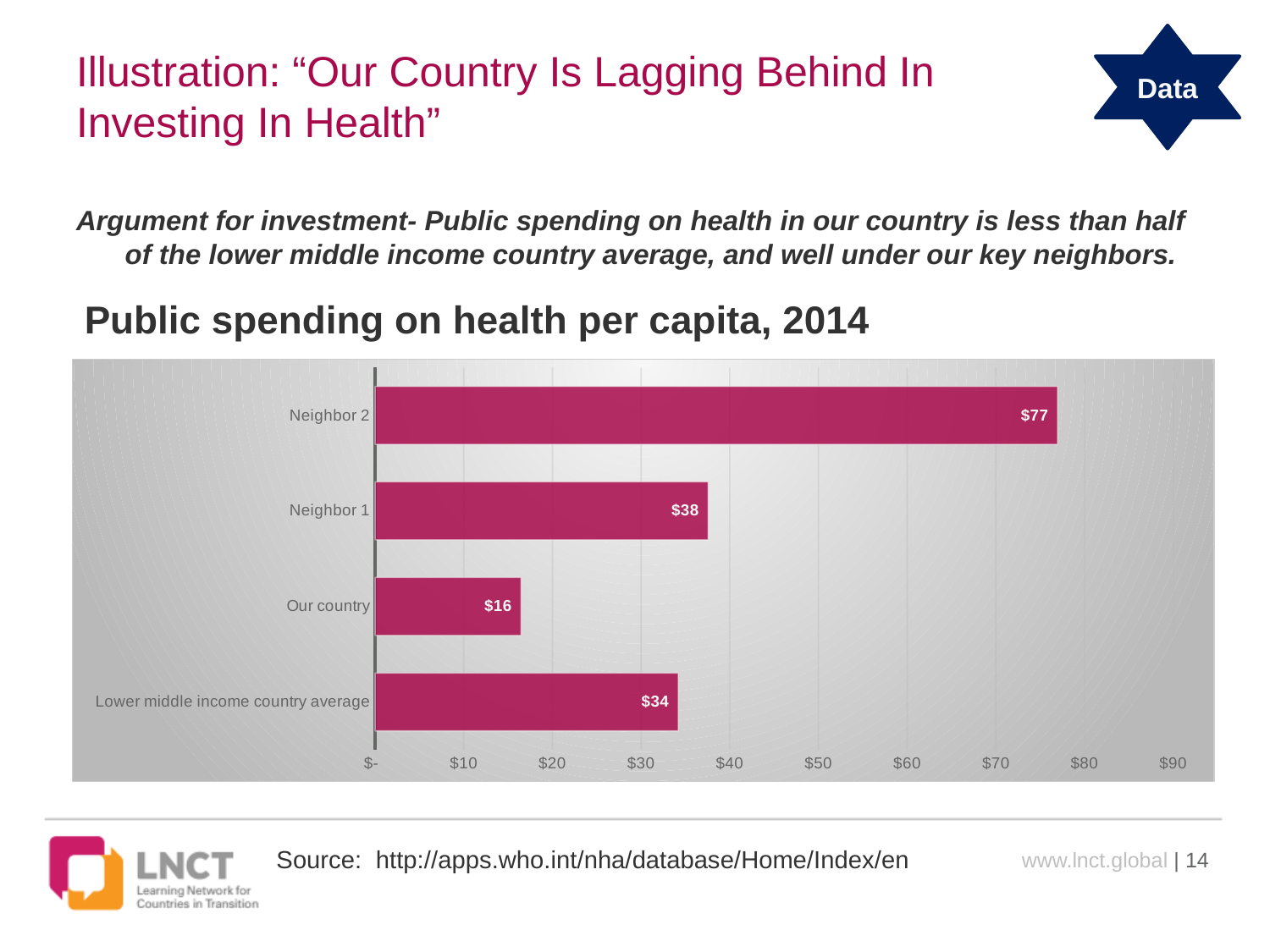
Which category has the highest public spending on health per capita? Neighbor 2 Is the value for Neighbor 1 greater or less than $40? less How many categories are shown in the chart? 4 What is the title of the chart? Public spending on health per capita, 2014 What is the difference between Neighbor 2 and Neighbor 1 in public spending on health per capita? $39 Which category has the lowest public spending on health per capita? Our country What is the public spending on health per capita for Neighbor 2? $77 What is the public spending on health per capita for Our country? $16 What is the value shown for the Lower middle income country average? $34 What is the difference between the Lower middle income country average and Our country? $18 What kind of chart is shown on the slide? Bar chart Which is larger, the value for Neighbor 1 or the Lower middle income country average? Neighbor 1